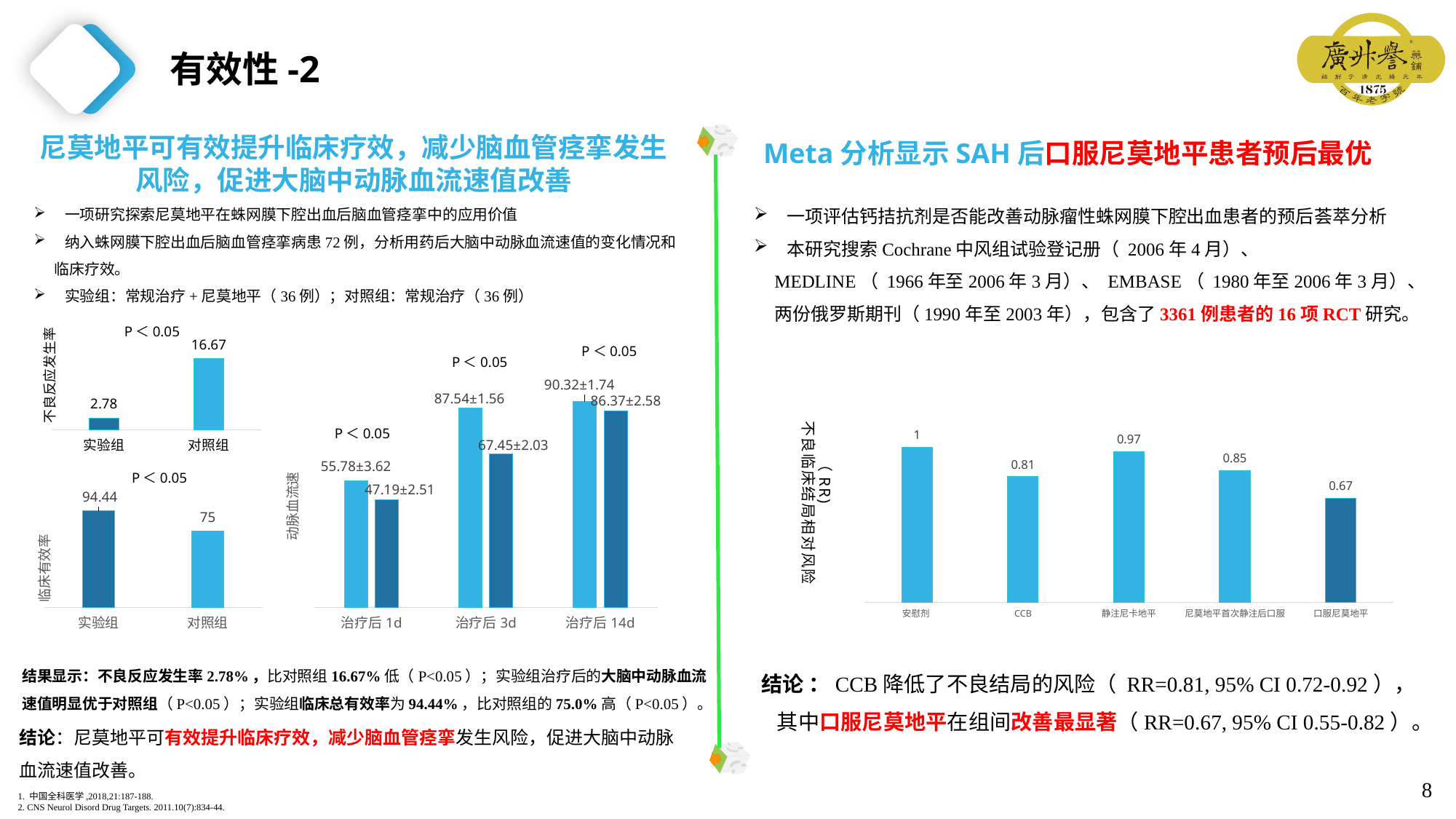
In the RR chart on the right, which is larger, the value for CCB or the value for 静注尼卡地平? 静注尼卡地平 In the 临床有效率 chart at the bottom left, what is the value for 实验组? 94.44 In the 临床有效率 chart at the bottom left, what is the difference between 实验组 and 对照组? 19.44 In the RR chart on the right, which category has the highest value? 安慰剂 In the RR chart on the right, which category has the lowest value? 口服尼莫地平 In the 动脉血流速 chart in the middle of the slide, how many time-point categories are shown on the x axis? 3 In the 不良反应发生率 chart at the top left, what is the value for 实验组? 2.78 In the 动脉血流速 chart in the middle of the slide, what is the value of the darker blue bar at 治疗后 1d? 47.19±2.51 In the RR chart on the right, what is the value for 口服尼莫地平? 0.67 In the 动脉血流速 chart in the middle of the slide, what is the value of the lighter blue bar at 治疗后 3d? 87.54±1.56 In the 动脉血流速 chart in the middle of the slide, do the lighter blue bars rise or fall from 治疗后 1d to 治疗后 14d? rise In the 不良反应发生率 chart at the top left, what is the value for 对照组? 16.67